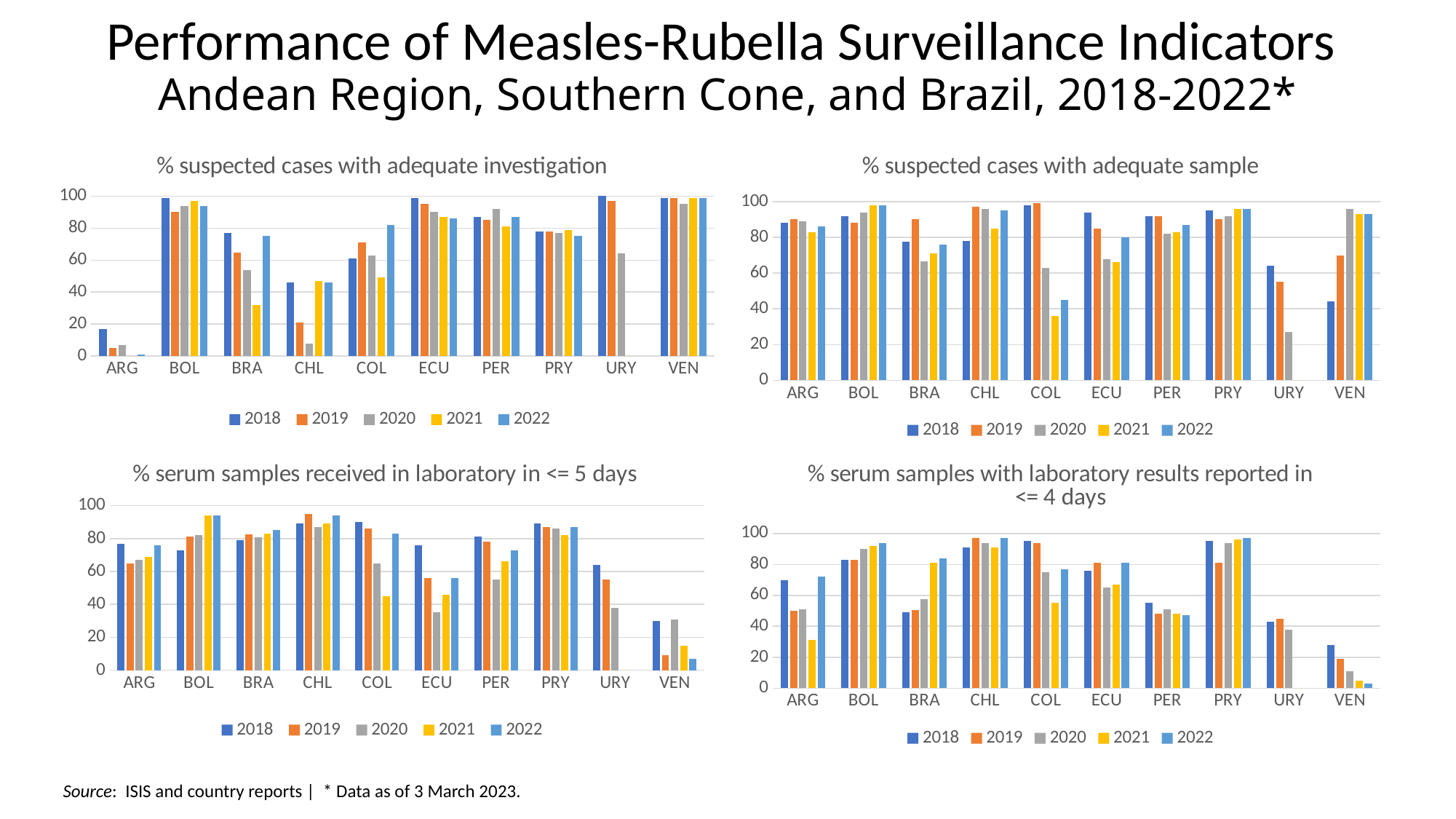
On the '% suspected cases with adequate sample' chart, is the 2020 value for URY greater or less than 40? less How many countries are shown on the x axis of the '% suspected cases with adequate sample' chart? 10 On the '% suspected cases with adequate investigation' chart, which is larger for BRA, the 2021 value or the 2022 value? 2022 On the '% serum samples received in laboratory in <= 5 days' chart, which country has the lowest 2019 value? VEN How many series does the legend list on the '% serum samples received in laboratory in <= 5 days' chart? 5 What kind of chart is the '% suspected cases with adequate investigation' chart? bar chart On the '% serum samples received in laboratory in <= 5 days' chart, is the 2020 value for ECU greater or less than 40? less How many charts are shown on the slide? 4 On the '% suspected cases with adequate investigation' chart, is the 2018 value for ARG greater or less than 20? less On the '% serum samples with laboratory results reported in <= 4 days' chart, which is larger for ARG, the 2018 value or the 2019 value? 2018